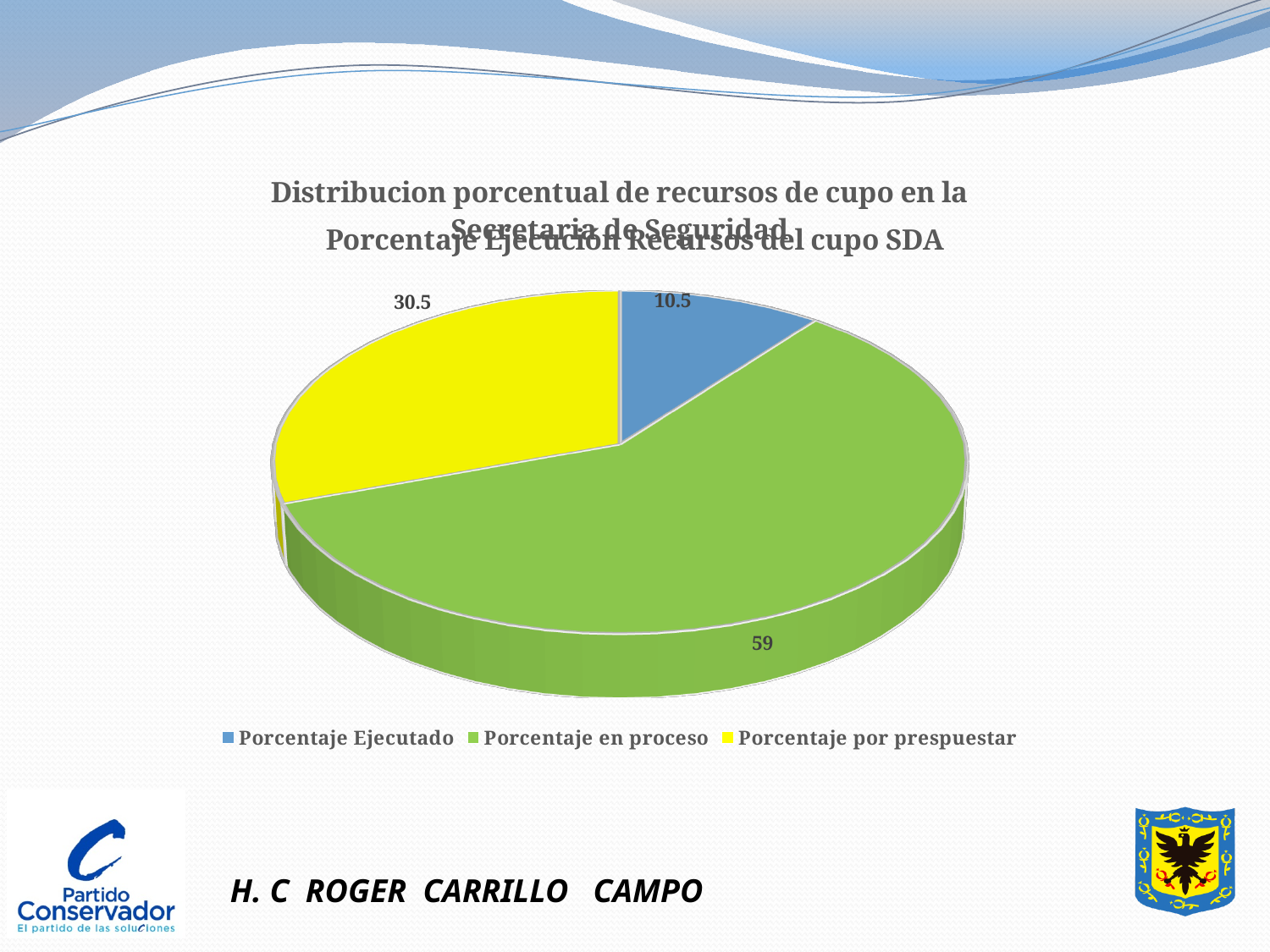
How many entries does the legend list? 3 What is the difference between the values for Porcentaje por prespuestar and Porcentaje Ejecutado? 20 How many slices does the pie chart have? 3 What colour is the slice for Porcentaje por prespuestar? Yellow What is the value for Porcentaje por prespuestar in the pie chart? 30.5 Which category has the smallest slice of the pie chart? Porcentaje Ejecutado Which category has the largest slice of the pie chart? Porcentaje en proceso What kind of chart is shown on the slide? Pie chart What is the value for Porcentaje en proceso in the pie chart? 59 What is the value for Porcentaje Ejecutado in the pie chart? 10.5 Which is larger, Porcentaje por prespuestar or Porcentaje Ejecutado? Porcentaje por prespuestar What is the difference between the values for Porcentaje en proceso and Porcentaje Ejecutado? 48.5